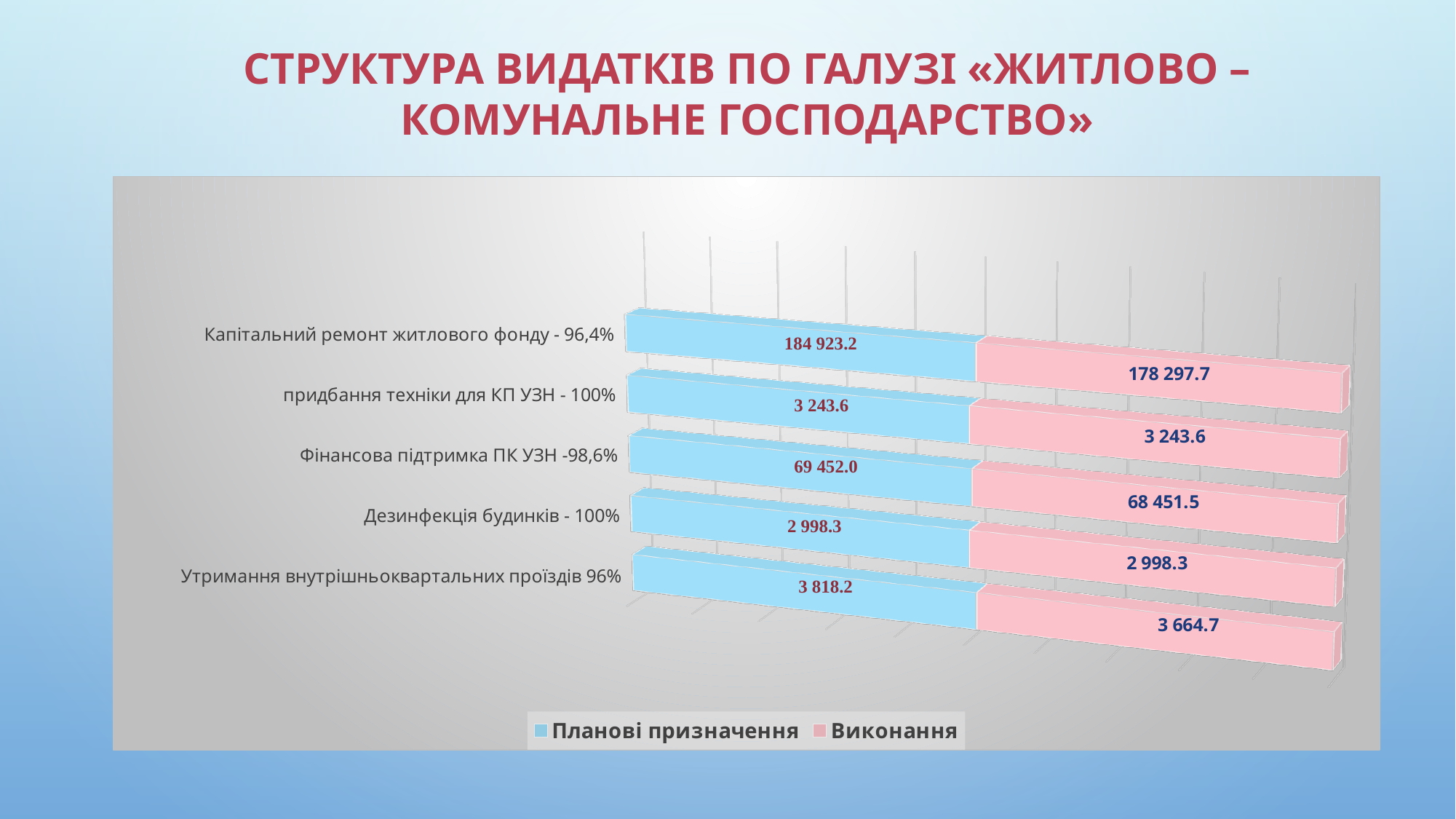
How many categories are shown in the chart? 5 How many series does the legend list? 2 What kind of chart is shown on the slide? bar chart What is the value of Планові призначення for Капітальний ремонт житлового фонду - 96,4%? 184 923.2 Which category has the highest Планові призначення value? Капітальний ремонт житлового фонду - 96,4% What is the value of Виконання for Капітальний ремонт житлового фонду - 96,4%? 178 297.7 What is the difference between Планові призначення and Виконання for Фінансова підтримка ПК УЗН -98,6%? 1 000.5 What is the value of Виконання for Фінансова підтримка ПК УЗН -98,6%? 68 451.5 Which colour represents the Виконання series in the chart? pink Which is larger for Утримання внутрішньоквартальних проїздів 96%: Планові призначення or Виконання? Планові призначення Which category has the lowest Виконання value? Дезинфекція будинків - 100% What is the value of Планові призначення for Утримання внутрішньоквартальних проїздів 96%? 3 818.2